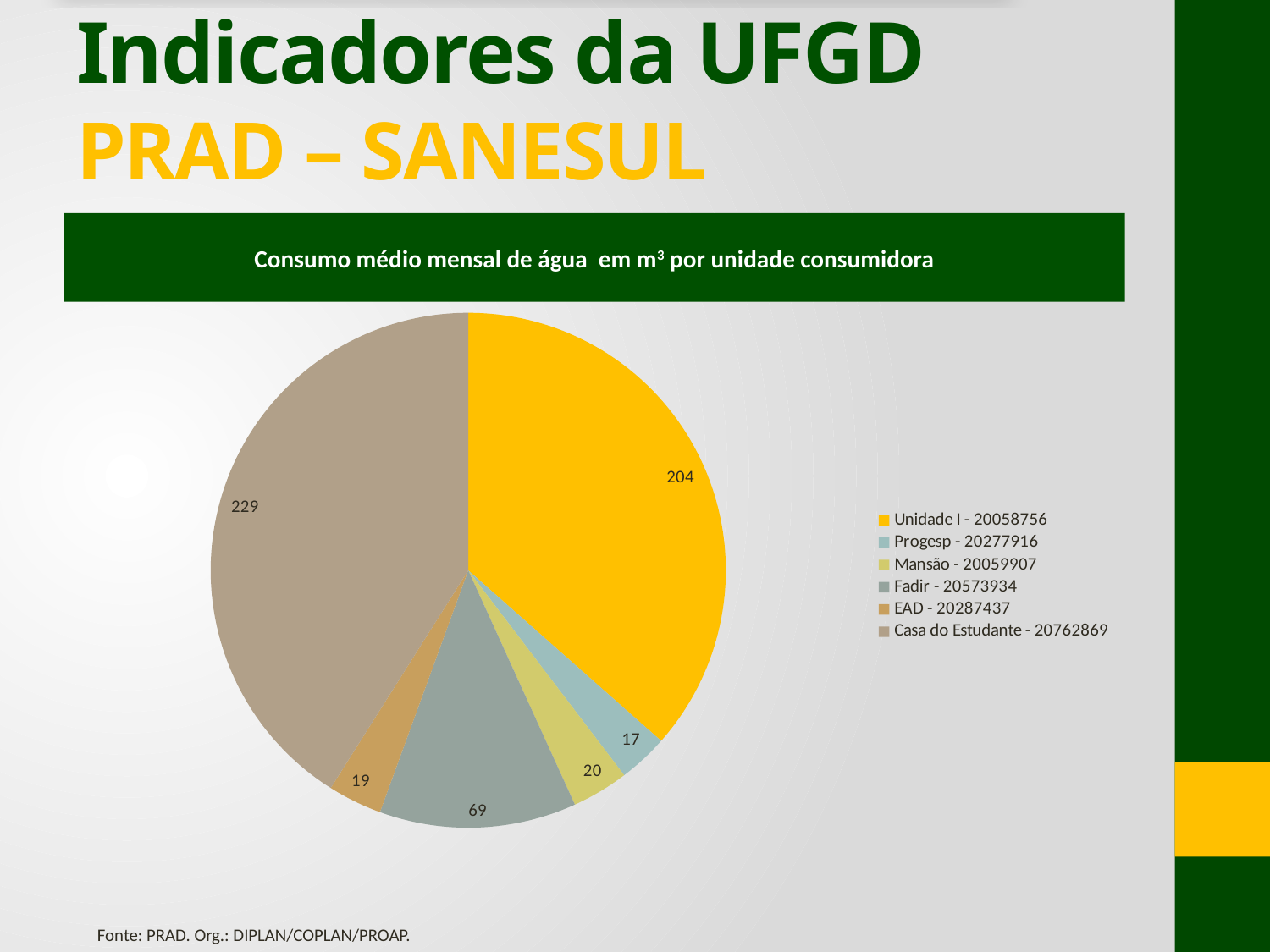
What is the difference between the values for Casa do Estudante - 20762869 and Unidade I - 20058756? 25 Which unit has the smallest slice of the pie chart? Progesp - 20277916 What is the value for Fadir - 20573934 in the pie chart? 69 What is the total of all the values shown in the pie chart? 558 Which unit has the largest slice of the pie chart? Casa do Estudante - 20762869 What is the value for Casa do Estudante - 20762869 in the pie chart? 229 Which is larger, the value for Fadir - 20573934 or the value for Mansão - 20059907? Fadir - 20573934 What is the title of the chart on the slide? Consumo médio mensal de água em m³ por unidade consumidora What is the value for Unidade I - 20058756 in the pie chart? 204 What kind of chart is shown on the slide? Pie chart How many slices does the pie chart have? 6 What is the value for Progesp - 20277916 in the pie chart? 17